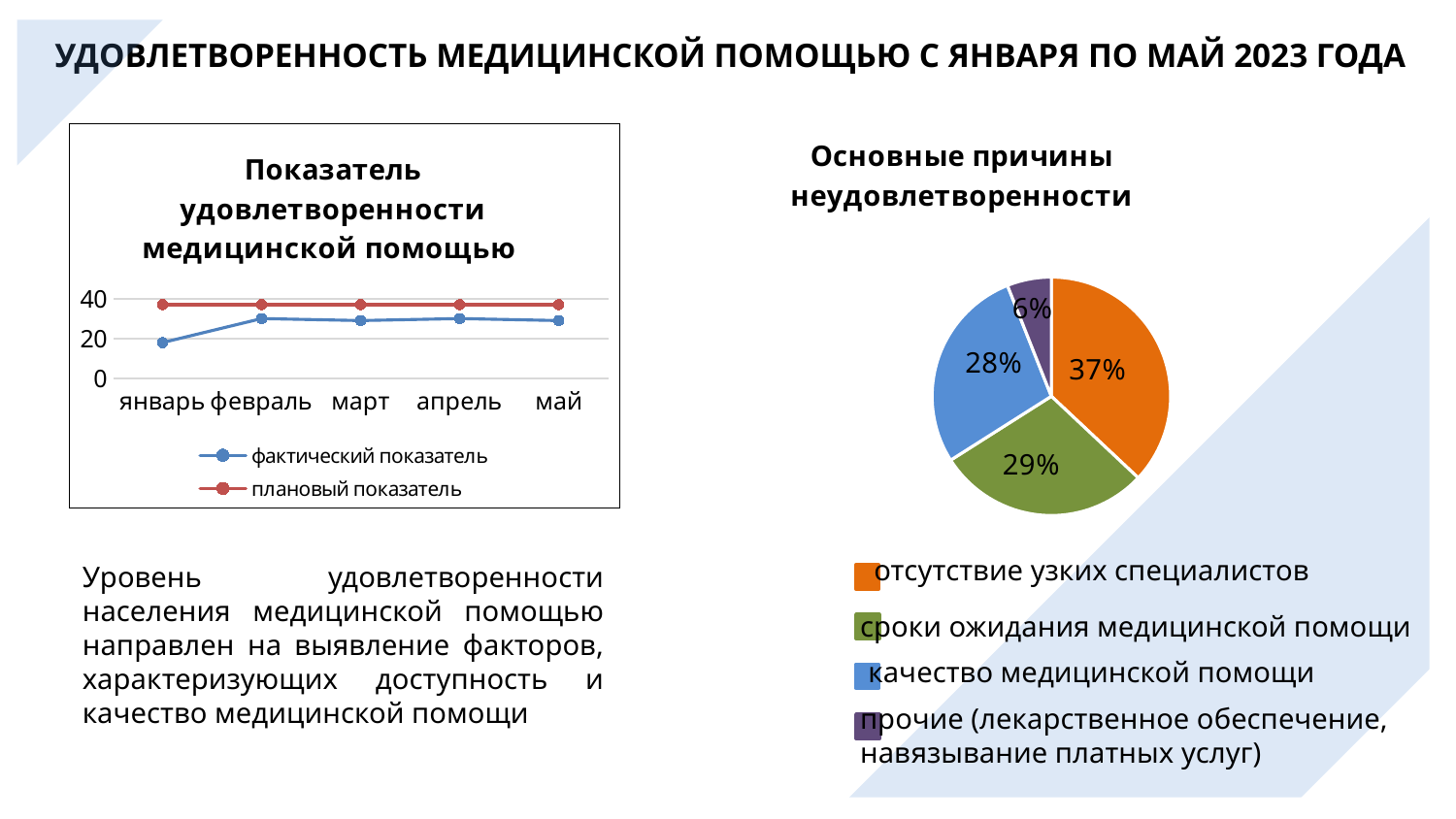
What kind of chart is the chart titled «Основные причины неудовлетворенности»? pie chart In the chart «Показатель удовлетворенности медицинской помощью», is the value of «плановый показатель» for май greater or less than 20? greater In the chart «Основные причины неудовлетворенности», what share does «отсутствие узких специалистов» have? 37% In the chart «Основные причины неудовлетворенности», which cause has the largest share? отсутствие узких специалистов In the chart «Показатель удовлетворенности медицинской помощью», which is larger in январь: «фактический показатель» or «плановый показатель»? плановый показатель In the chart «Основные причины неудовлетворенности», which cause has the smallest share? прочие (лекарственное обеспечение, навязывание платных услуг) In the chart «Показатель удовлетворенности медицинской помощью», how many months are shown on the x axis? 5 What kind of chart is the chart titled «Показатель удовлетворенности медицинской помощью»? line chart In the chart «Показатель удовлетворенности медицинской помощью», how many series does the legend list? 2 In the chart «Основные причины неудовлетворенности», what share does «прочие (лекарственное обеспечение, навязывание платных услуг)» have? 6% In the chart «Основные причины неудовлетворенности», how many slices does the pie have? 4 In the chart «Показатель удовлетворенности медицинской помощью», is the value of «фактический показатель» for январь greater or less than 20? less